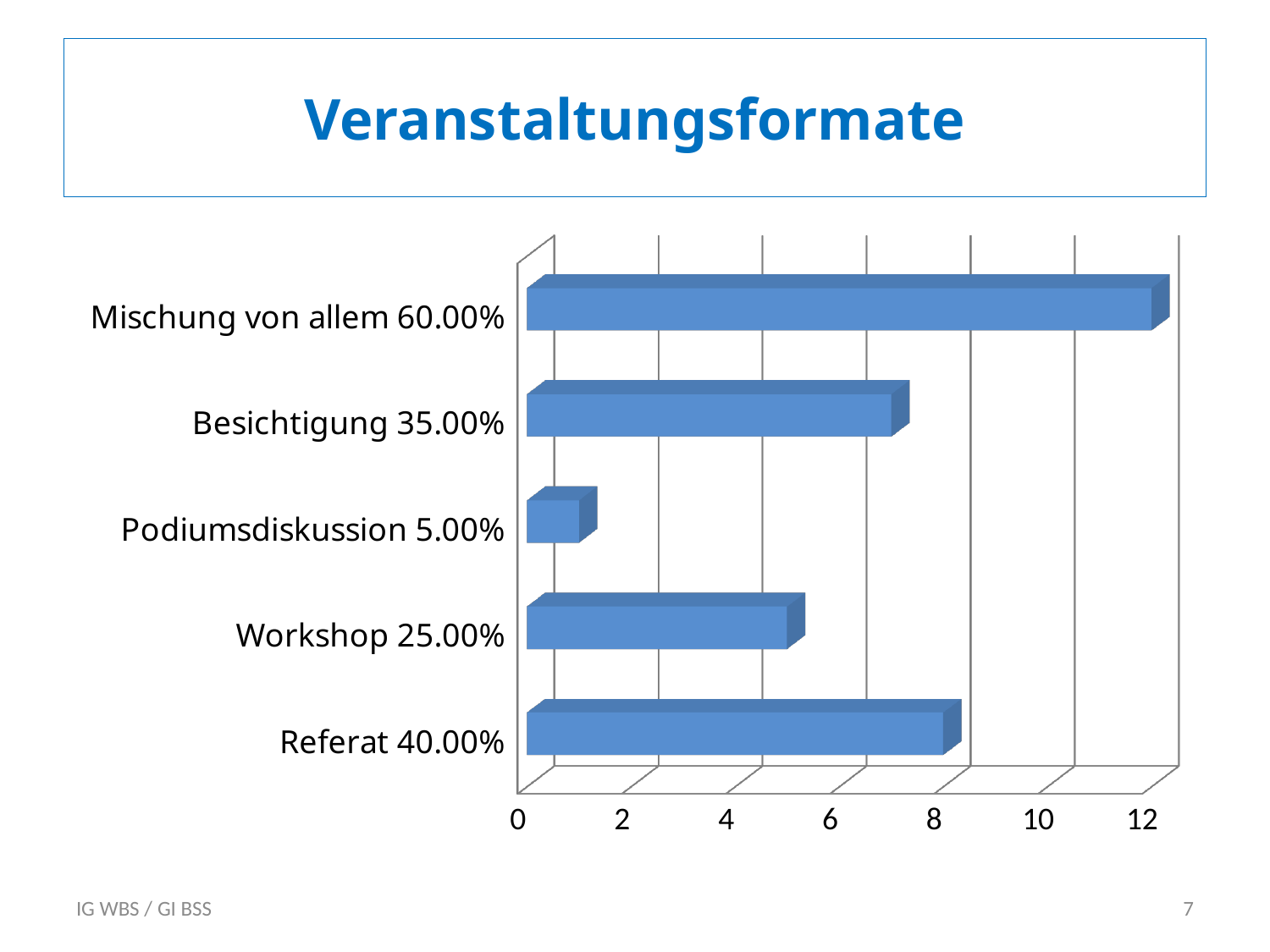
Is the bar for Besichtigung greater or less than 6? greater Which category has the shortest bar? Podiumsdiskussion Which category has the longest bar? Mischung von allem Is the bar for Podiumsdiskussion greater or less than 2? less What percentage is shown in the label for Referat? 40.00% How many categories are plotted in the chart? 5 What is the difference between the percentages shown for Mischung von allem and Referat? 20.00% What type of chart is shown on the slide? bar chart What percentage is shown in the label for Besichtigung? 35.00% What percentage is shown in the label for Workshop? 25.00% What is the title of the slide containing the chart? Veranstaltungsformate Which bar is longer, Referat or Workshop? Referat